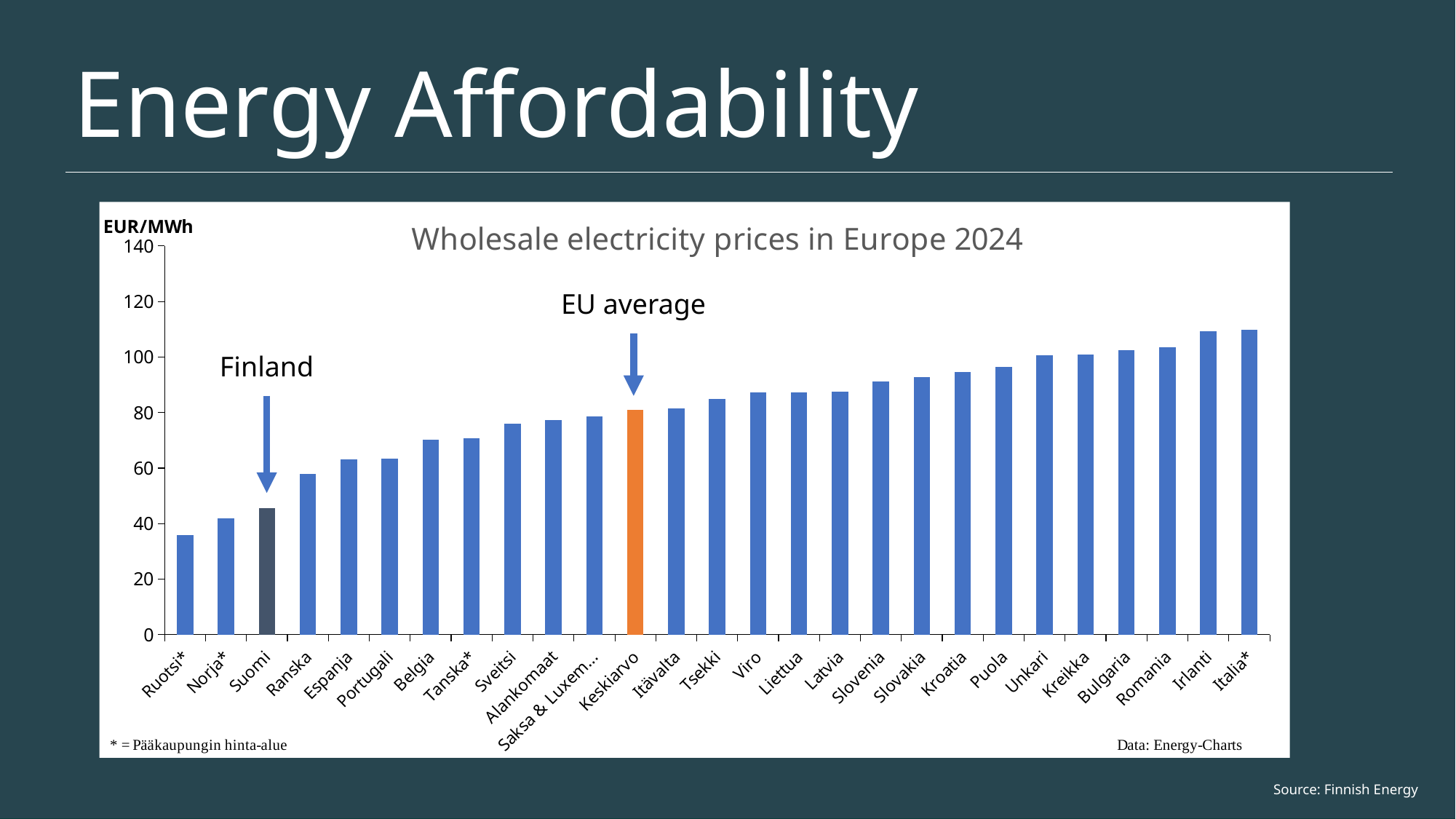
Which category has the lowest wholesale electricity price in the chart? Ruotsi* Is the value for Suomi greater or less than 60? less What is the title of the chart? Wholesale electricity prices in Europe 2024 How many bars (countries/categories) are plotted in the chart? 27 Do the values rise or fall moving from left to right along the x axis? rise Which is larger, the value for Suomi or the value for Keskiarvo? Keskiarvo Which is larger, the value for Ruotsi* or the value for Italia*? Italia* What unit is shown on the vertical axis of the chart? EUR/MWh Is the value for Italia* greater or less than 100? greater Is the value for Keskiarvo greater or less than 100? less What kind of chart is shown on the slide? bar chart